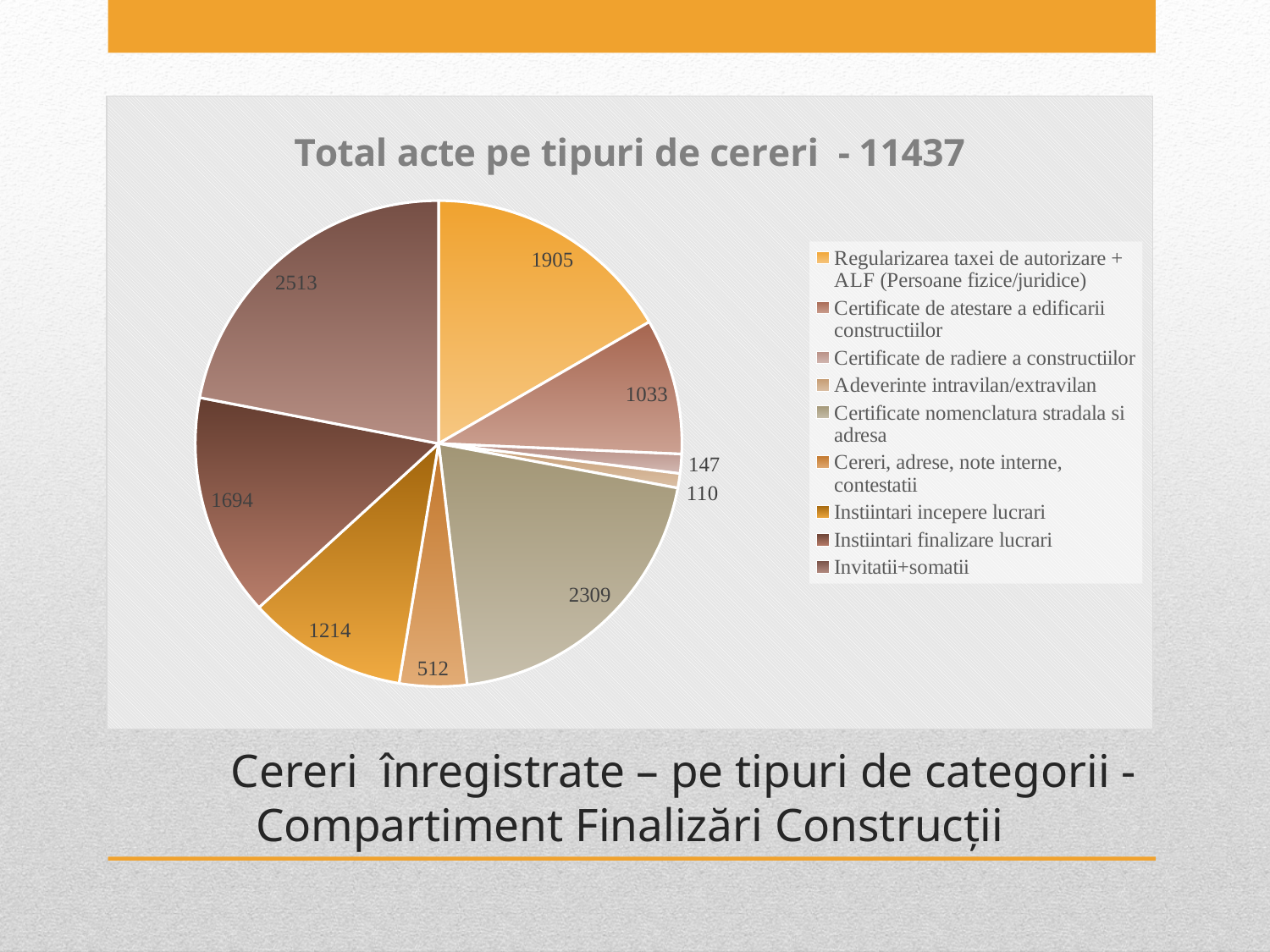
What is the title of the chart? Total acte pe tipuri de cereri - 11437 What is the difference between the values for Invitatii+somatii and Certificate nomenclatura stradala si adresa? 204 What is the value for Regularizarea taxei de autorizare + ALF (Persoane fizice/juridice)? 1905 What is the value for Certificate nomenclatura stradala si adresa? 2309 Which is larger, the value for Instiintari incepere lucrari or the value for Certificate de atestare a edificarii constructiilor? Instiintari incepere lucrari Which category has the largest slice of the pie? Invitatii+somatii How many categories does the legend of the pie chart list? 9 What type of chart is shown on the slide? pie chart Which category has the smallest slice of the pie? Adeverinte intravilan/extravilan What is the value for Instiintari finalizare lucrari? 1694 What is the value for Invitatii+somatii? 2513 What is the value for Adeverinte intravilan/extravilan? 110